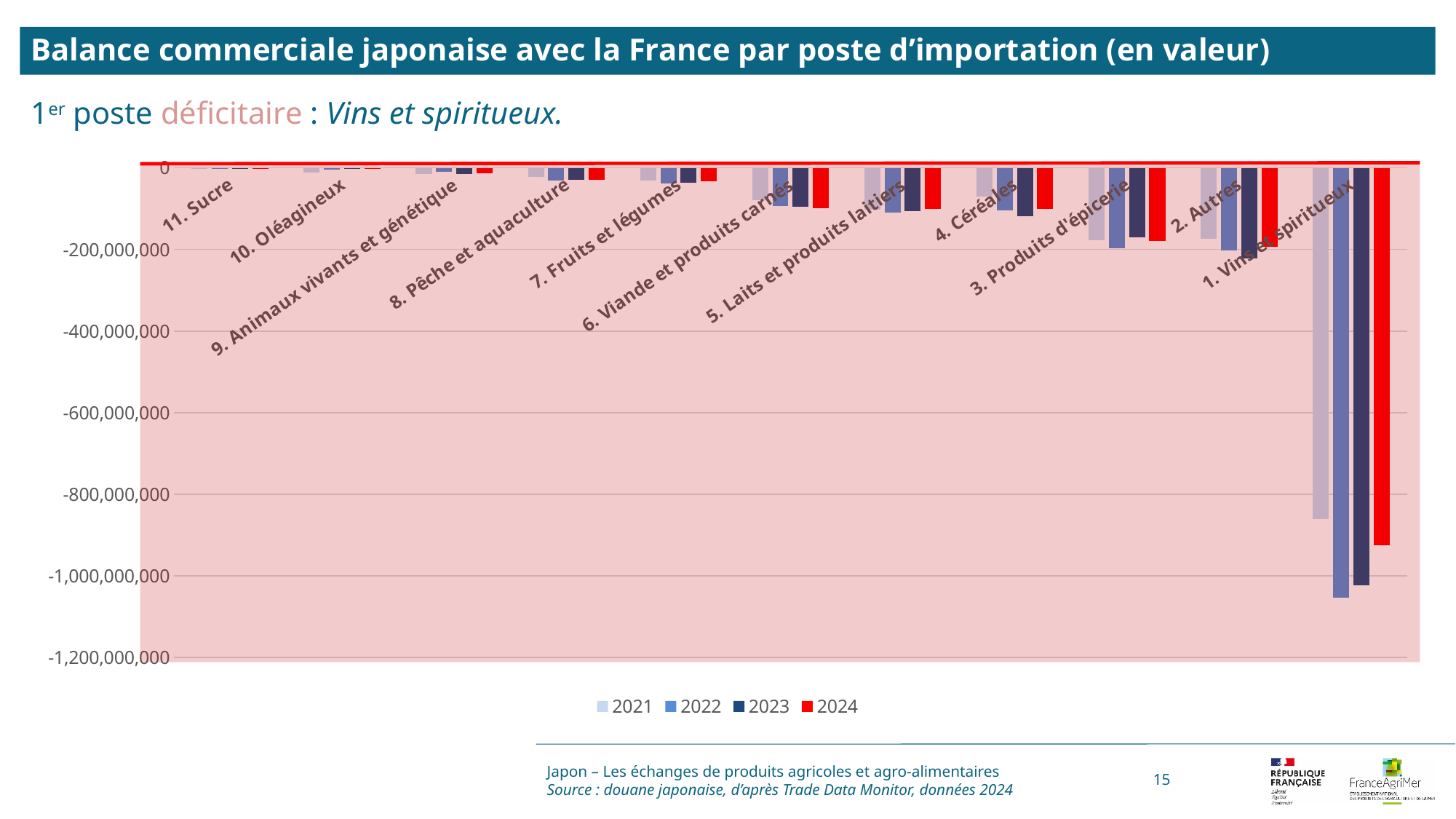
Moving from left to right along the x axis, do the deficit bars generally get longer or shorter? longer Which category has the smallest deficit (bars closest to zero)? 11. Sucre How many import categories are shown on the x axis of the chart? 11 For 1. Vins et spiritueux, which year shows the more negative value, 2021 or 2022? 2022 Is the 2021 value for 1. Vins et spiritueux greater or less than -1,000,000,000? greater Is the 2024 value for 5. Laits et produits laitiers greater or less than -200,000,000? greater Is the 2022 value for 1. Vins et spiritueux greater or less than -1,000,000,000? less What kind of chart is shown on the slide? bar chart How many series does the chart legend list? 4 Which category has the largest deficit (the most negative bars)? 1. Vins et spiritueux What is the title of the chart on the slide? Balance commerciale japonaise avec la France par poste d'importation (en valeur) Which years are listed in the chart legend? 2021, 2022, 2023, 2024